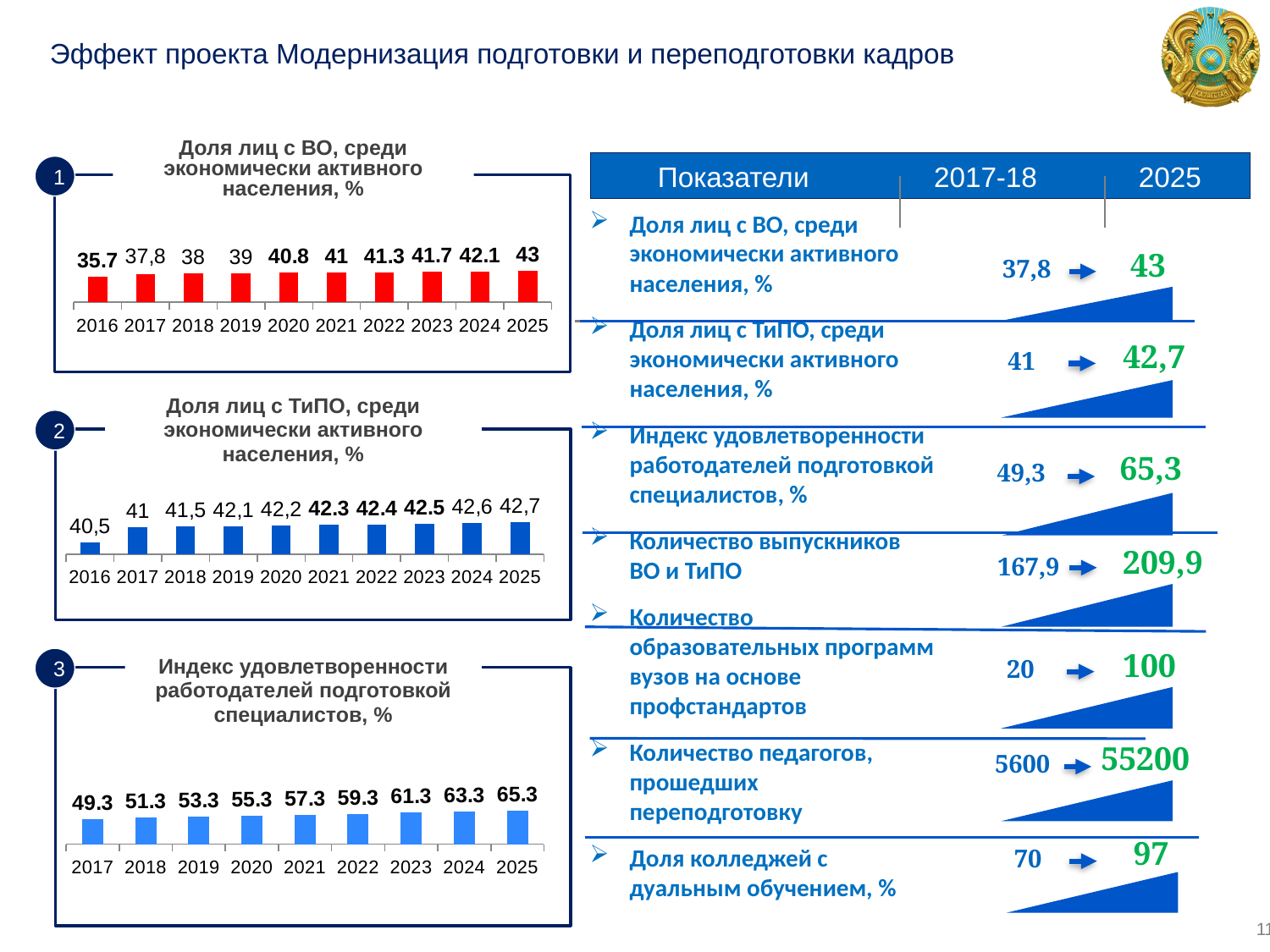
What type of chart is the one titled "Индекс удовлетворенности работодателей подготовкой специалистов, %"? bar chart In the chart titled "Доля лиц с ТиПО, среди экономически активного населения, %", do the values rise or fall from 2016 to 2025? rise In the chart titled "Доля лиц с ТиПО, среди экономически активного населения, %", what is the value for 2016? 40,5 In the chart titled "Доля лиц с ВО, среди экономически активного населения, %", what is the difference between the 2025 and 2016 values? 7.3 In the chart titled "Доля лиц с ВО, среди экономически активного населения, %", which year has the lowest value? 2016 In the chart titled "Доля лиц с ТиПО, среди экономически активного населения, %", which year has the highest value? 2025 In the chart titled "Индекс удовлетворенности работодателей подготовкой специалистов, %", what is the difference between the 2025 and 2017 values? 16 In the chart titled "Доля лиц с ВО, среди экономически активного населения, %", what is the value for 2025? 43 In the chart titled "Доля лиц с ВО, среди экономически активного населения, %", what is the value for 2016? 35.7 In the chart titled "Доля лиц с ТиПО, среди экономически активного населения, %", what is the value for 2022? 42.4 In the chart titled "Индекс удовлетворенности работодателей подготовкой специалистов, %", what is the value for 2021? 57.3 In the chart titled "Доля лиц с ВО, среди экономически активного населения, %", how many years are shown on the x axis? 10